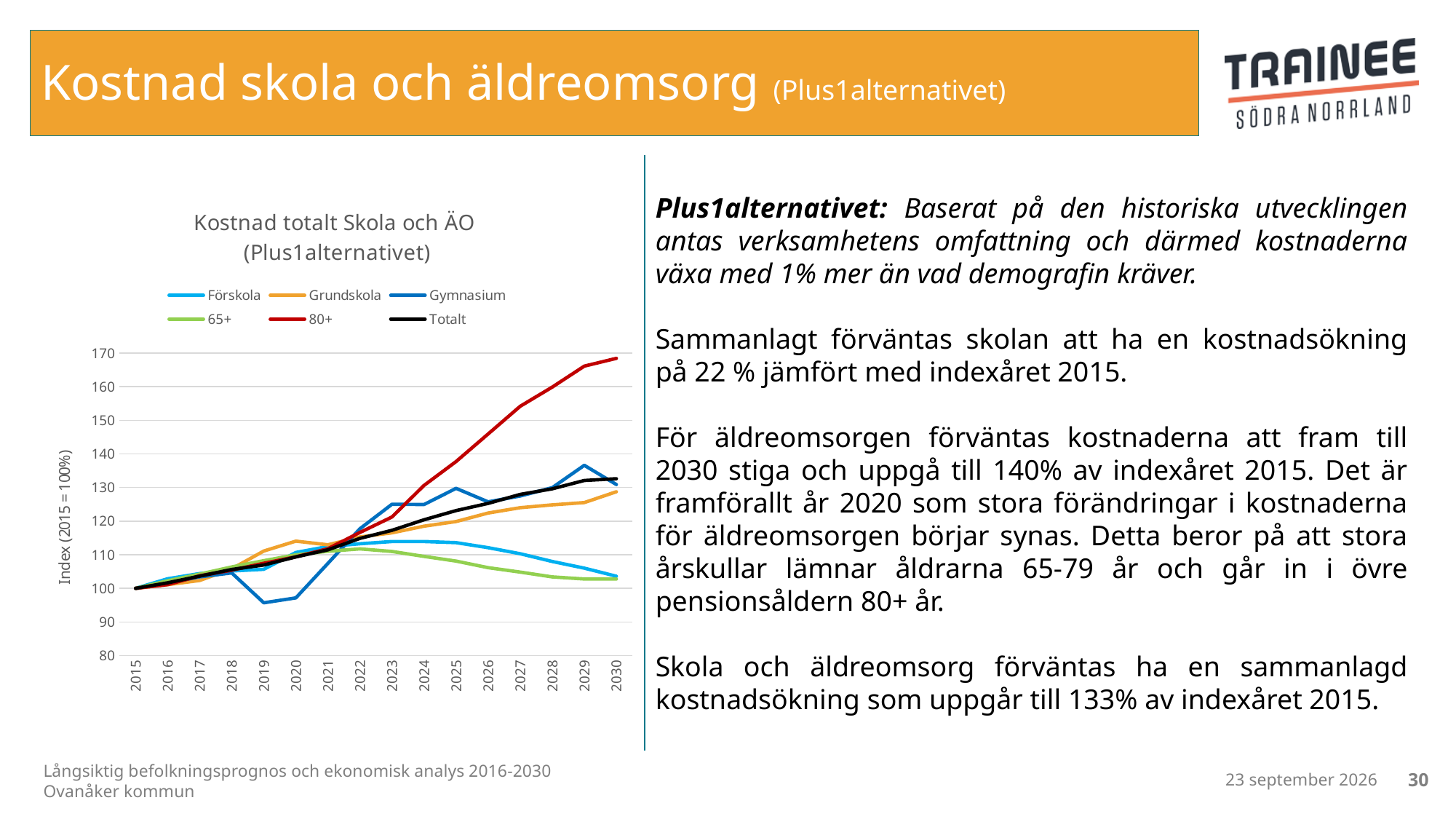
Is the value for 80+ in 2030 greater or less than 160? greater What kind of chart is shown on the slide? line chart How many series does the legend of the chart list? 6 Which series has the highest value in 2030? 80+ What is the index value of all series in 2015? 100 In 2030, which is larger: the value for 80+ or the value for Grundskola? 80+ Is the value for Grundskola in 2030 greater or less than 120? greater Does the 80+ series rise or fall from 2015 to 2030? rise Which series has the lowest value in 2019? Gymnasium What is the label on the y axis of the chart? Index (2015 = 100%) How many years are shown along the x axis of the chart? 16 Is the value for Gymnasium in 2019 greater or less than 100? less